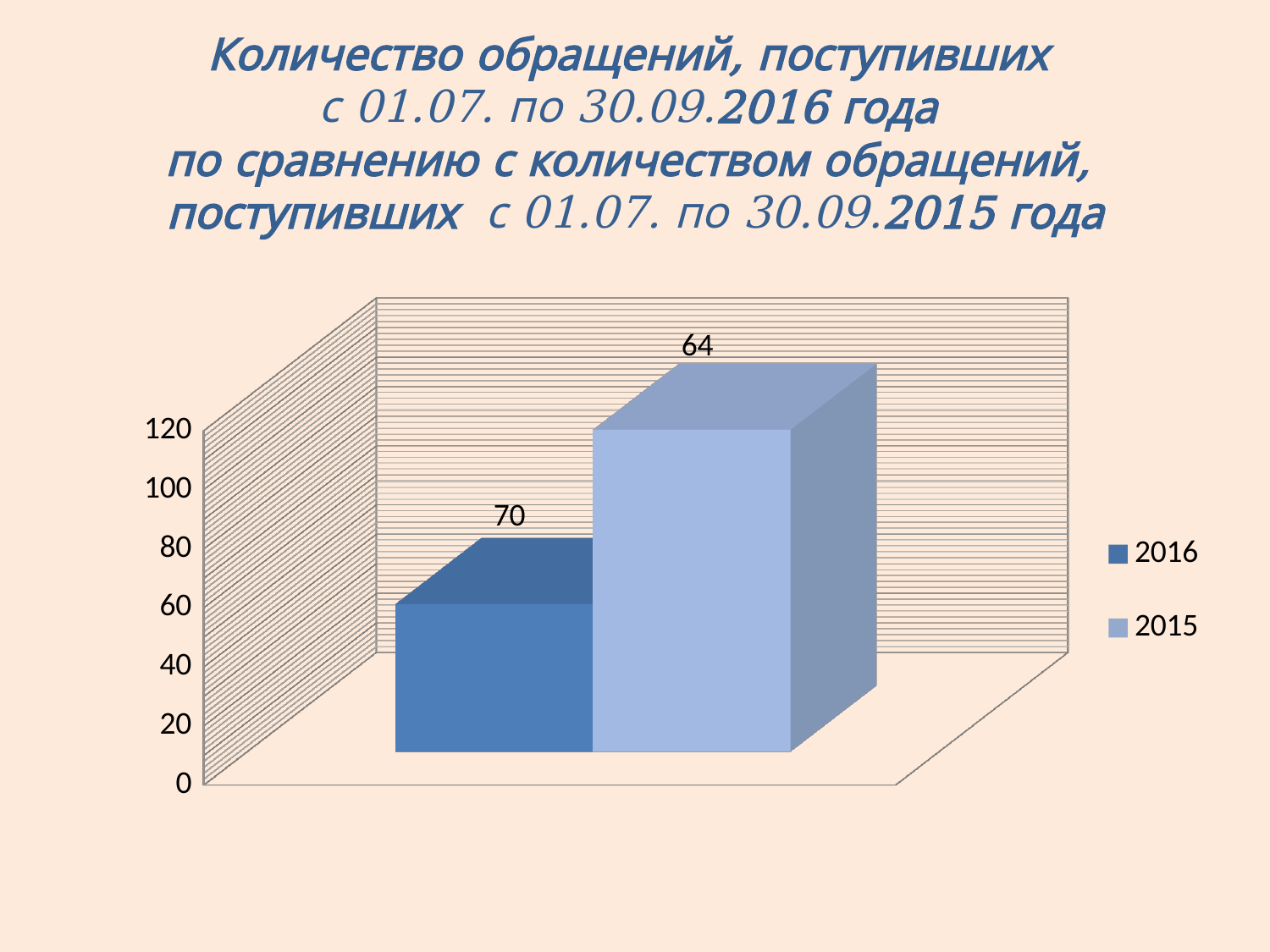
According to the data labels, which series has the highest value? 2016 What kind of chart is shown on the slide? Bar chart What is the difference between the 2016 value and the 2015 value? 6 How many series does the legend list? 2 According to the data labels, which series has the lowest value? 2015 Which series is shown in the lighter blue colour in the legend? 2015 What is the value shown for the 2015 series? 64 According to the data labels, which series has the higher value, 2016 or 2015? 2016 What is the value shown for the 2016 series? 70 What is the highest value shown on the vertical axis? 120 How many bars are plotted in the chart? 2